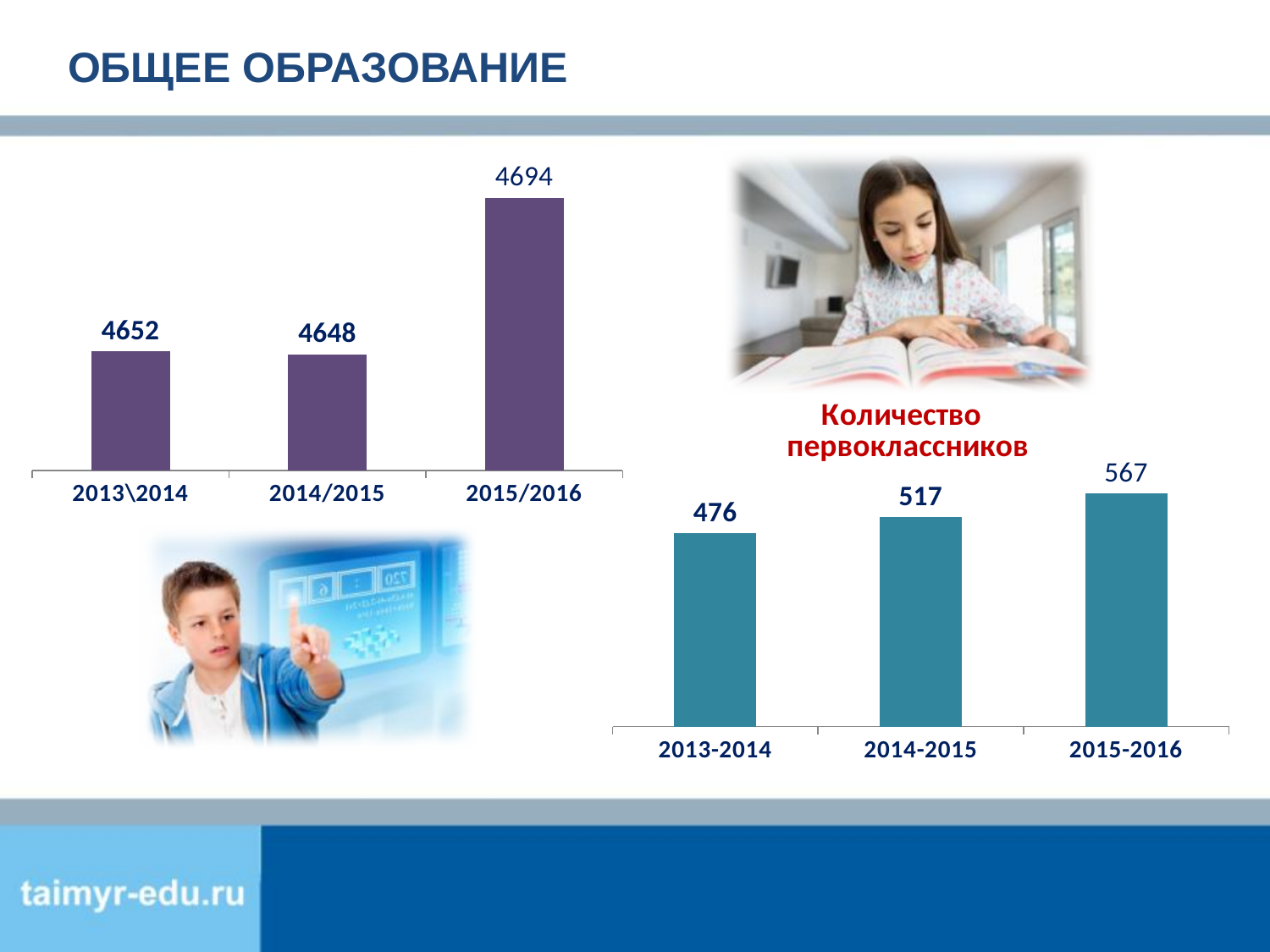
In the chart titled 'Количество первоклассников', which year has the lowest value? 2013-2014 In the top-left chart, which year has the highest value? 2015/2016 In the top-left chart, what is the difference between the values for 2015/2016 and 2013\2014? 42 In the chart titled 'Количество первоклассников', what is the difference between the values for 2015-2016 and 2014-2015? 50 In the chart titled 'Количество первоклассников', what is the value for 2013-2014? 476 In the top-left chart, which is larger: the value for 2013\2014 or the value for 2014/2015? 2013\2014 In the chart titled 'Количество первоклассников', what is the value for 2015-2016? 567 What type of chart is the chart titled 'Количество первоклассников'? bar chart In the top-left chart, what is the value for 2014/2015? 4648 In the top-left chart, how many bars are plotted? 3 In the top-left chart, what is the value for 2015/2016? 4694 In the chart titled 'Количество первоклассников', do the values rise or fall from 2013-2014 to 2015-2016? rise